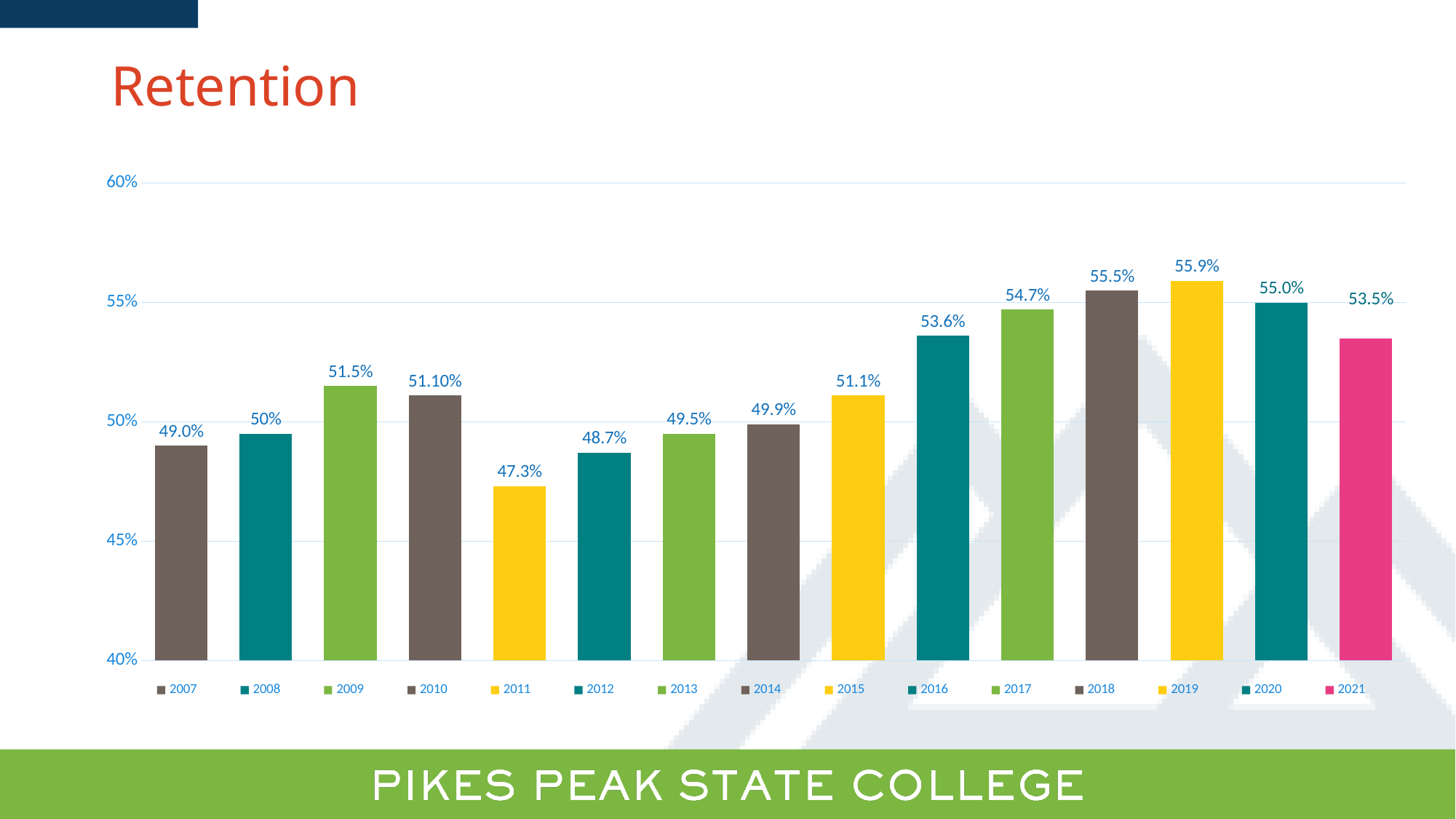
How many years are plotted in the chart? 15 Which is larger, the retention value for 2018 or for 2020? 2018 What is the retention value for 2021? 53.5% What is the retention value for 2019? 55.9% What kind of chart is shown on the slide? Bar chart What is the difference between the retention values for 2019 and 2011? 8.6 percentage points Do the retention values rise or fall from 2016 to 2019? Rise What is the retention value for 2011? 47.3% Which year has the highest retention value? 2019 Which year has the lowest retention value? 2011 What is the title of the slide? Retention Is the value for 2016 greater or less than 50%? greater